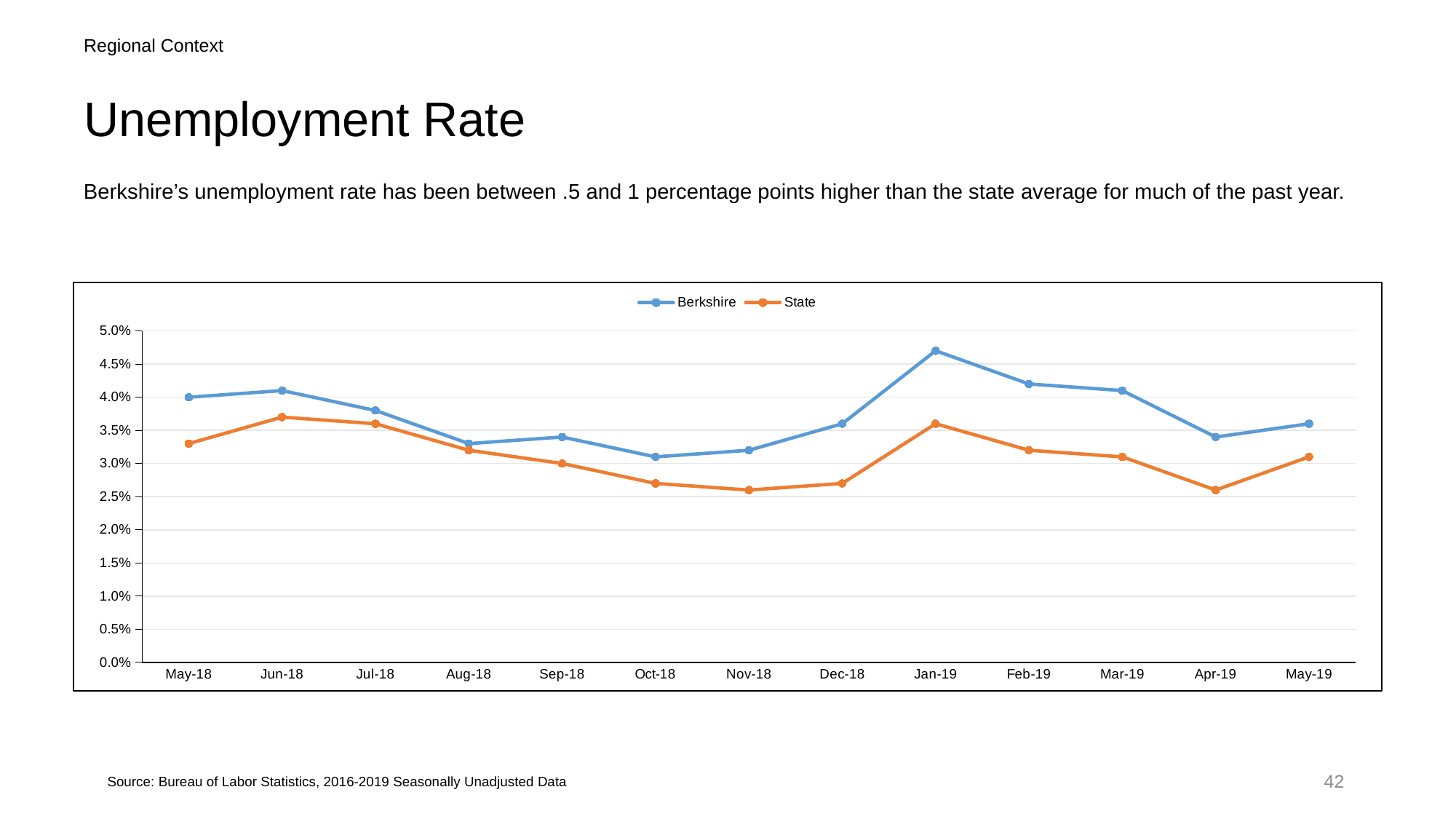
In Jan-19, which series has the larger value, Berkshire or State? Berkshire Is the Berkshire value for Jan-19 greater or less than 4.5%? greater How many months are plotted along the x axis of the chart? 13 Is the State value for Nov-18 greater or less than 3.0%? less Which colour is used for the State series in the chart? Orange In which month does the Berkshire series reach its highest value? Jan-19 Is the State value for Jun-18 greater or less than 3.5%? greater How many series does the chart legend list? 2 What kind of chart is shown on the slide? Line chart Does the Berkshire series rise or fall from Jan-19 to Apr-19? Fall Does the State series rise or fall from Nov-18 to Jan-19? Rise